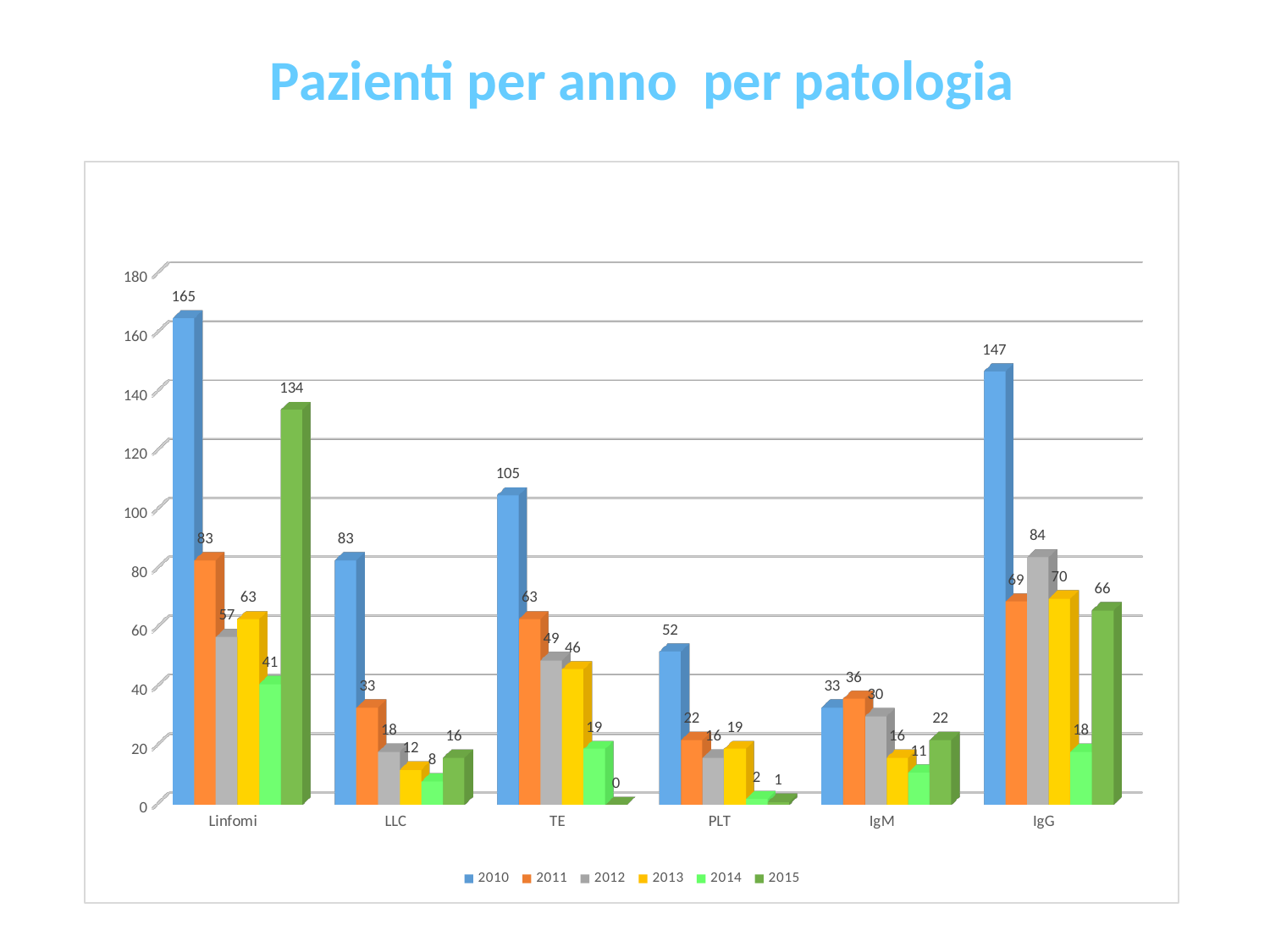
Do the values for PLT rise or fall from 2010 to 2015? Fall Which category has the lowest value in the 2010 series? IgM What is the title of the chart? Pazienti per anno per patologia Which category has the highest value in the 2015 series? Linfomi How many series does the legend list? 6 What is the value for Linfomi in 2010? 165 What kind of chart is shown on the slide? Bar chart What is the value for IgG in 2012? 84 What is the difference between the 2010 and 2015 values for Linfomi? 31 Which is larger for IgM: the 2010 value or the 2011 value? 2011 What is the value for TE in 2015? 0 How many categories are shown on the x axis? 6